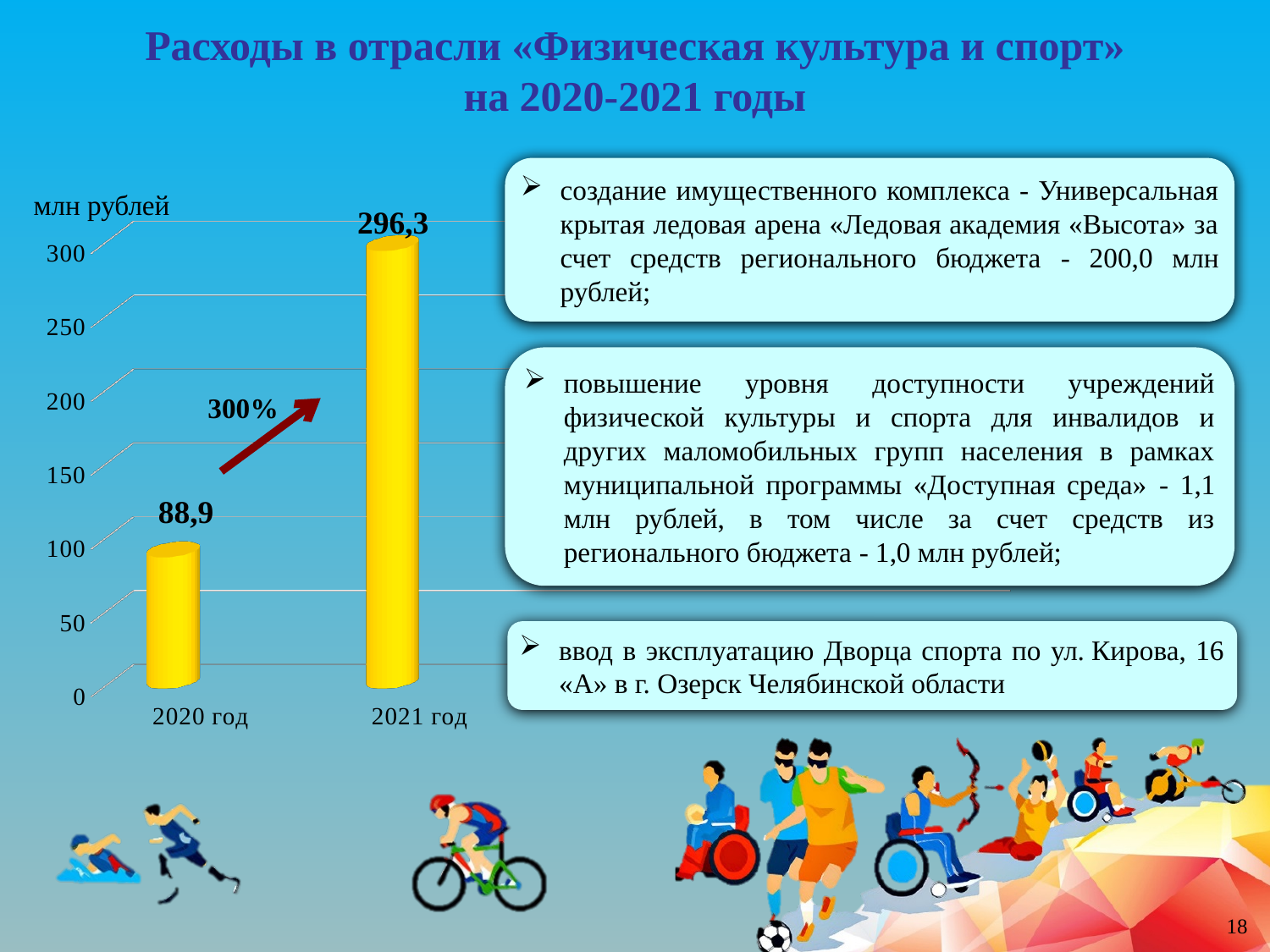
Is the value for 2021 год greater or less than 250? greater What is the value for 2021 год on the chart? 296,3 Which year has the highest value on the chart? 2021 год What kind of chart is shown on the slide? bar chart What is the value for 2020 год on the chart? 88,9 Which year has the lowest value on the chart? 2020 год What is the difference between the values for 2021 год and 2020 год? 207,4 How many categories (years) are shown on the chart? 2 Which is larger: the value for 2020 год or the value for 2021 год? 2021 год Do the values rise or fall from 2020 год to 2021 год? rise Is the value for 2020 год greater or less than 100? less What unit is indicated for the values on the chart? млн рублей